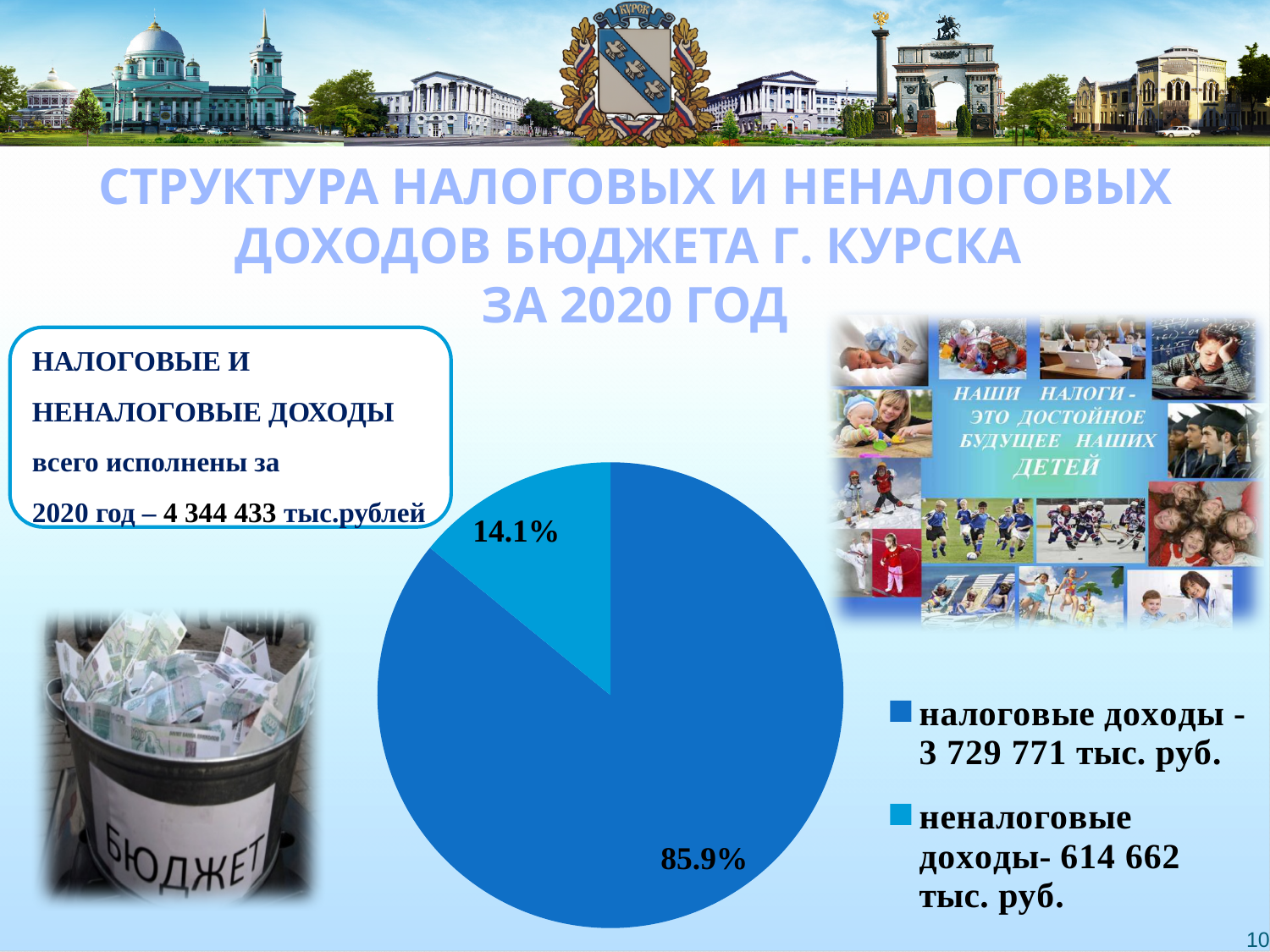
Which slice of the pie is the smallest? неналоговые доходы Which slice of the pie is the largest? налоговые доходы What is the difference in percentage points between the "налоговые доходы" and "неналоговые доходы" slices? 71.8 What share of the pie does "неналоговые доходы" take? 14.1% What kind of chart is shown on the slide? pie chart How many entries does the legend list? 2 Which is larger: the share for "налоговые доходы" or the share for "неналоговые доходы"? налоговые доходы What value in тыс. руб. does the legend give for "налоговые доходы"? 3 729 771 тыс. руб. What share of the pie does "налоговые доходы" take? 85.9% Which legend entry is shown in the lighter blue colour? неналоговые доходы How many slices does the pie chart have? 2 What value in тыс. руб. does the legend give for "неналоговые доходы"? 614 662 тыс. руб.